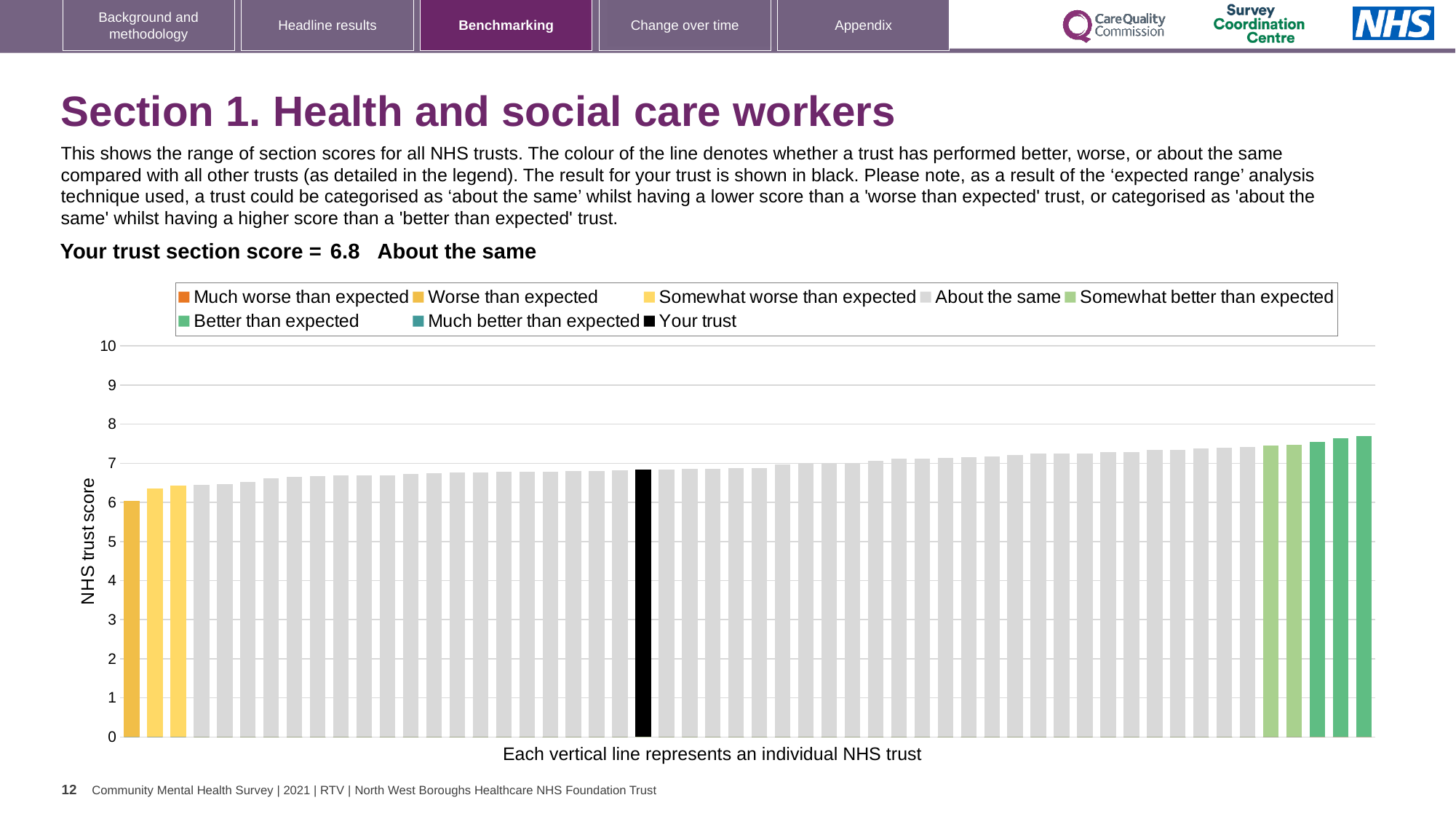
How many bars are coloured dark green ('Better than expected')? 3 What is the label on the vertical axis of the chart? NHS trust score How many bars are coloured yellow ('Worse than expected')? 1 Is the leftmost bar higher or lower than the black 'Your trust' bar? lower Is the value of the rightmost (highest) bar greater or less than 7? greater What kind of chart is shown on the slide? bar chart What is the section score for your trust shown on the slide? 6.8 Do the bar values rise or fall from left to right along the x axis? rise How many entries does the chart legend list? 8 Is the value of the black 'Your trust' bar greater or less than 5? greater Is the value of the leftmost (lowest) bar greater or less than 7? less Which category is your trust placed in for this section? About the same